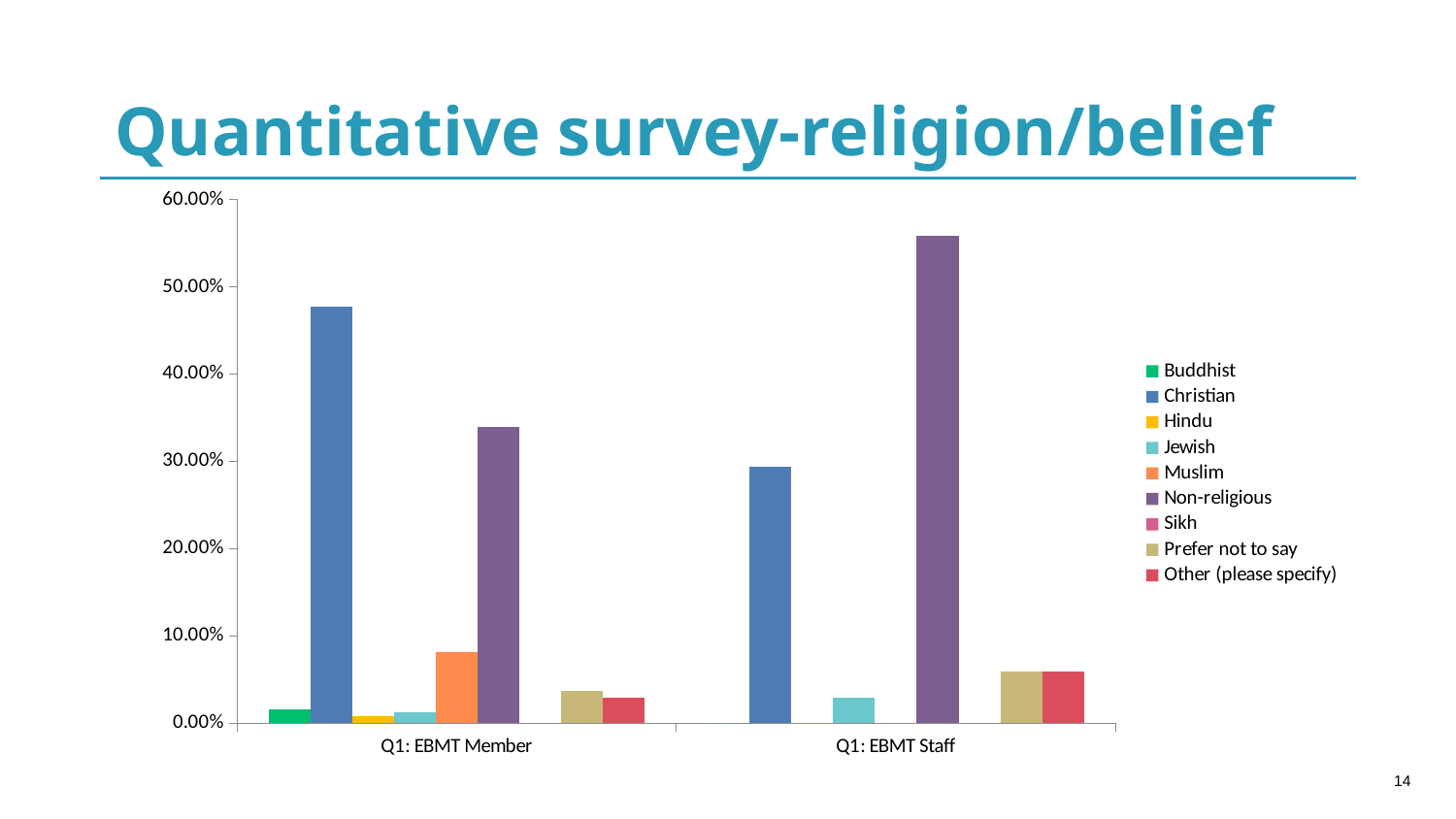
What kind of chart is shown on the slide? bar chart Which religion/belief has the highest value for Q1: EBMT Staff? Non-religious Is the Christian value for Q1: EBMT Staff greater or less than 20.00%? greater Is the Christian value larger for Q1: EBMT Member or Q1: EBMT Staff? Q1: EBMT Member Is the Muslim value for Q1: EBMT Member greater or less than 10.00%? less Is the Non-religious value for Q1: EBMT Staff greater or less than 50.00%? greater What is the title of the slide containing the chart? Quantitative survey-religion/belief How many series does the legend list? 9 Is the Non-religious value larger for Q1: EBMT Member or Q1: EBMT Staff? Q1: EBMT Staff Which religion/belief has the highest value for Q1: EBMT Member? Christian How many categories are shown on the x axis? 2